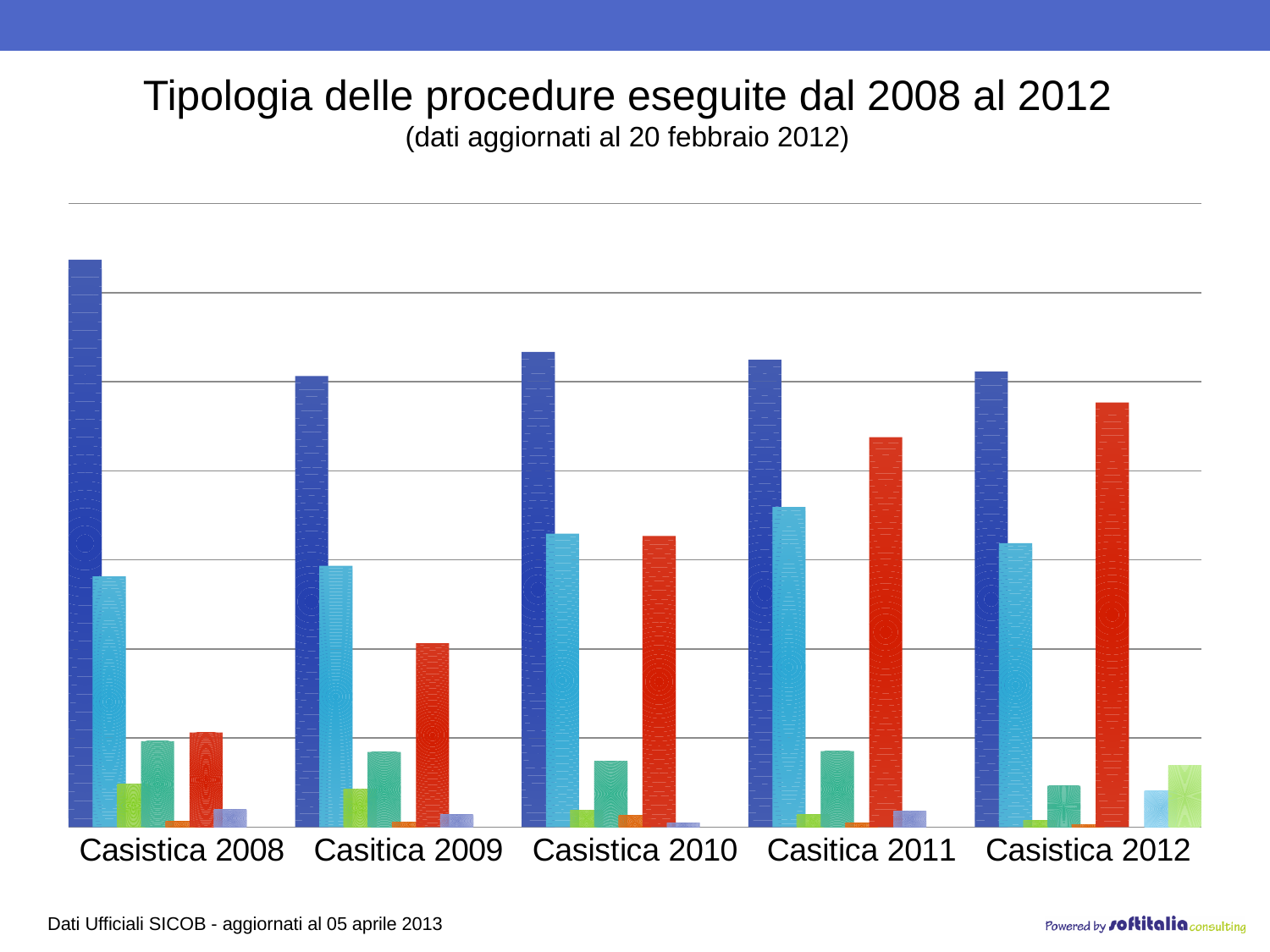
Do the red bars rise or fall from Casistica 2008 to Casistica 2012? rise What is the label of the first category on the x axis? Casistica 2008 In Casistica 2012, which is taller: the dark blue bar or the red bar? the dark blue bar How many categories are shown along the x axis of the chart? 5 In Casistica 2011, which is taller: the light blue bar or the red bar? the red bar In Casistica 2009, which is taller: the light blue bar or the red bar? the light blue bar In which category is the red bar the tallest? Casistica 2012 What is the title of the chart on the slide? Tipologia delle procedure eseguite dal 2008 al 2012 In which category is the red bar the shortest? Casistica 2008 What kind of chart is shown on the slide? bar chart In which category is the dark blue bar the tallest? Casistica 2008